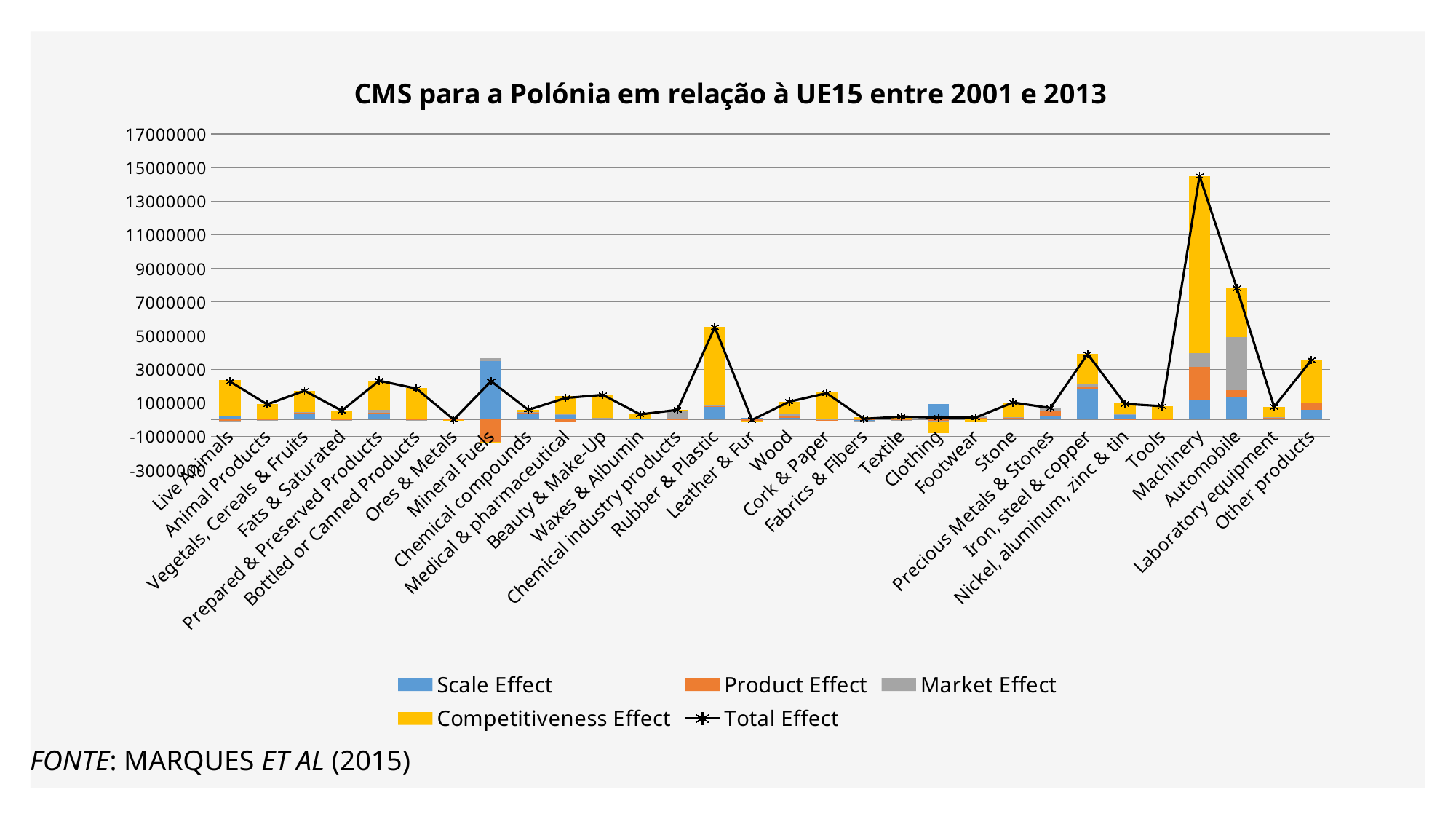
How many series does the legend list? 5 Is the Total Effect for Automobile greater or less than 7000000? greater Is the Total Effect for Machinery greater or less than 13000000? greater How many product categories are shown on the x axis? 30 Is the Total Effect for Live Animals greater or less than 3000000? less What kind of chart is this? bar chart (stacked bars with a line for Total Effect) Which category has the largest Scale Effect segment? Mineral Fuels Which category has the highest Total Effect? Machinery What is the title of the chart? CMS para a Polónia em relação à UE15 entre 2001 e 2013 Which has a larger Total Effect, Rubber & Plastic or Live Animals? Rubber & Plastic Which category has the largest Market Effect segment? Automobile Which has a larger Total Effect, Machinery or Automobile? Machinery